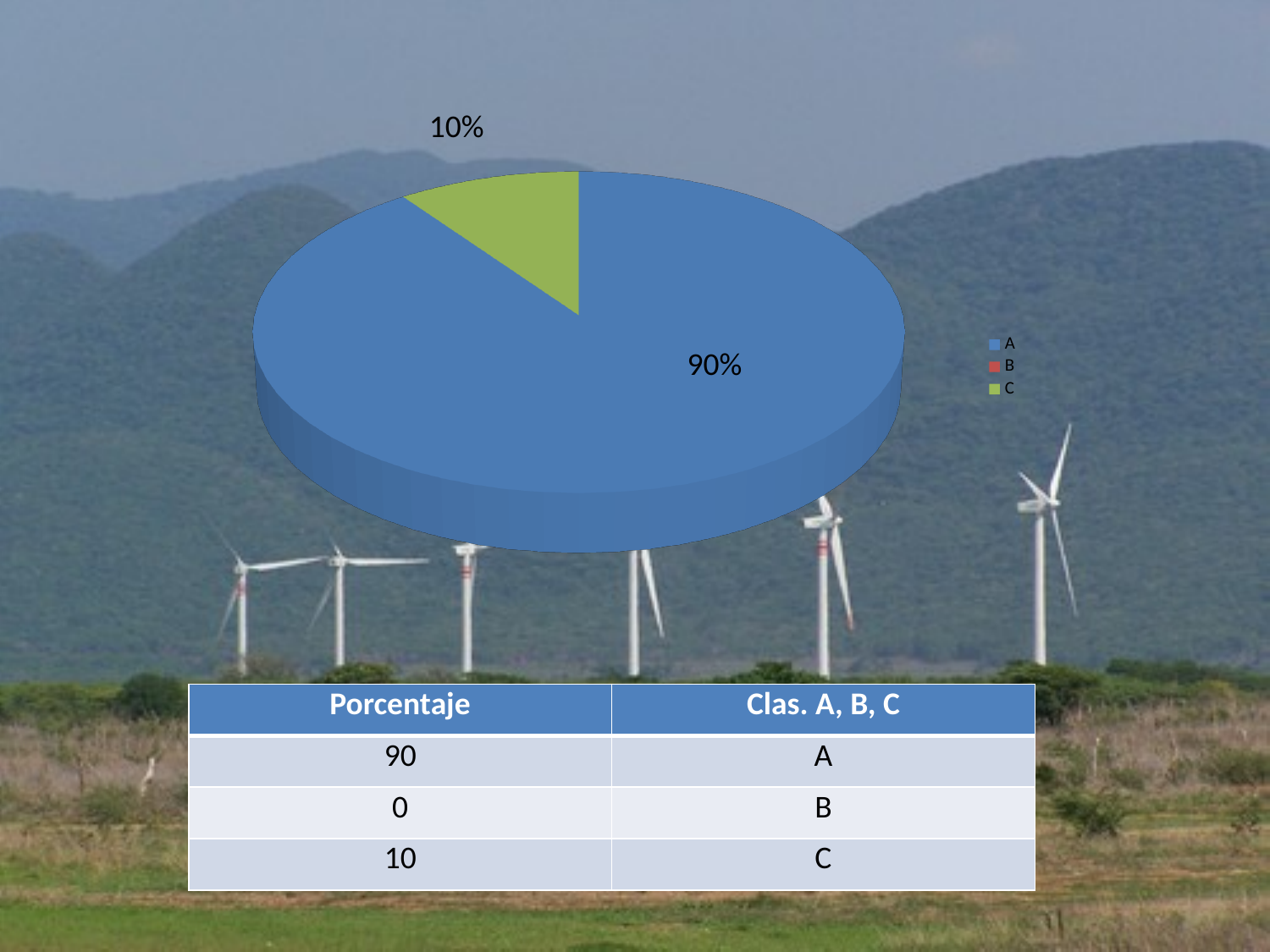
Which category has the smallest visible slice in the pie chart? C Which is larger in the pie chart, slice A or slice C? A According to the table, what is the percentage for category B? 0 Which category has the largest slice in the pie chart? A What kind of chart is shown on the slide? pie chart Is the value for slice A greater or less than 50%? greater What percentage does slice A represent in the pie chart? 90% What colour is slice C in the pie chart? green What colour is slice A in the pie chart? blue How many entries does the legend of the pie chart list? 3 What percentage does slice C represent in the pie chart? 10% What is the difference in percentage points between slice A and slice C? 80